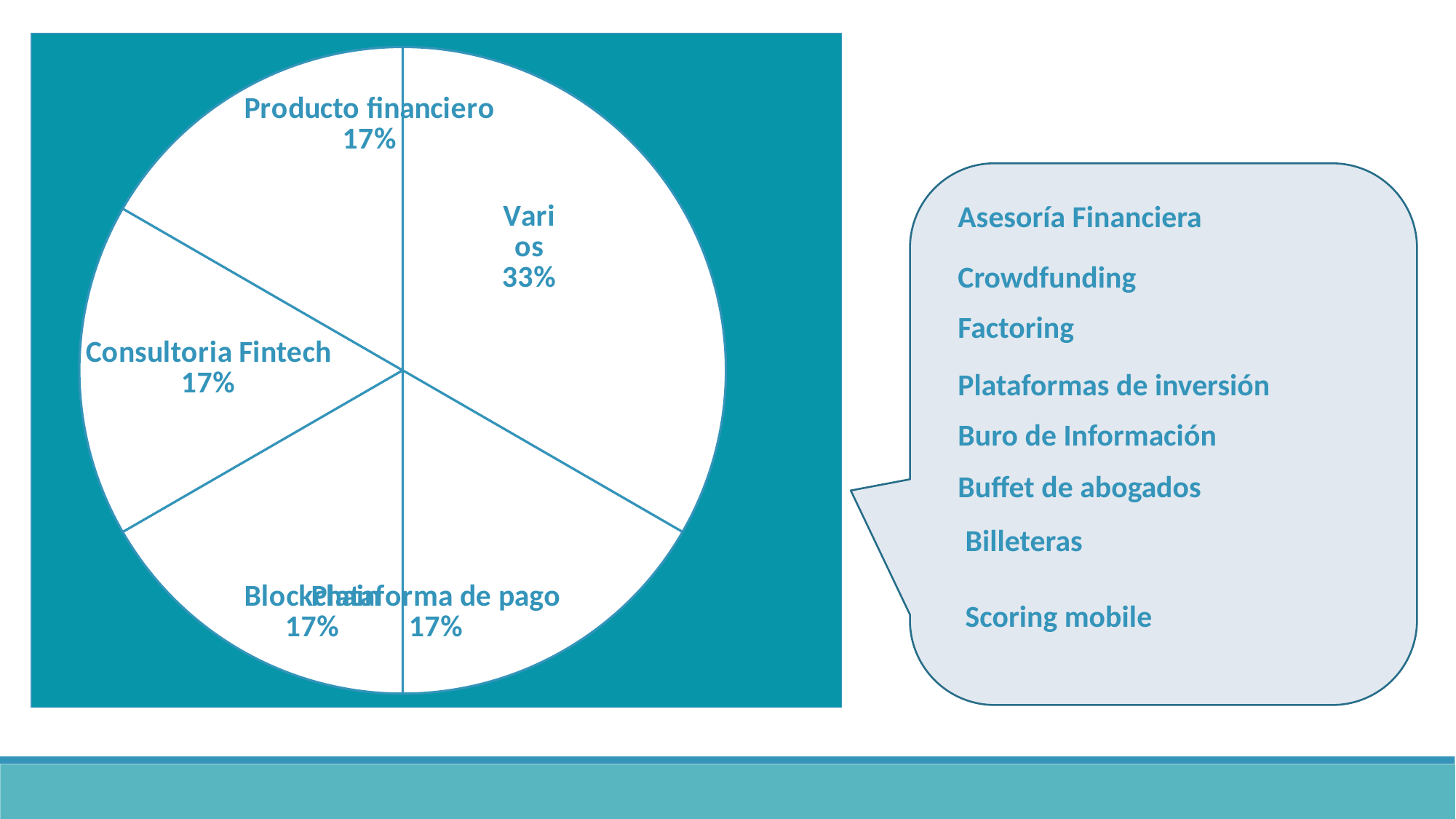
What percentage does the Varios slice represent? 33% Which slice of the pie chart is the largest? Varios What is the difference in percentage points between the Varios slice and the Producto financiero slice? 16 What percentage does the Producto financiero slice represent? 17% What share of the pie does the Varios slice take? 33% Which is larger, the Varios slice or the Consultoria Fintech slice? Varios How many items are listed in the callout box next to the pie chart? 8 How many slices does the pie chart have? 5 What kind of chart is shown on the slide? pie chart What percentage does the Consultoria Fintech slice represent? 17% What is the first item listed in the callout box next to the pie chart? Asesoría Financiera What percentage does the Plataforma de pago slice represent? 17%